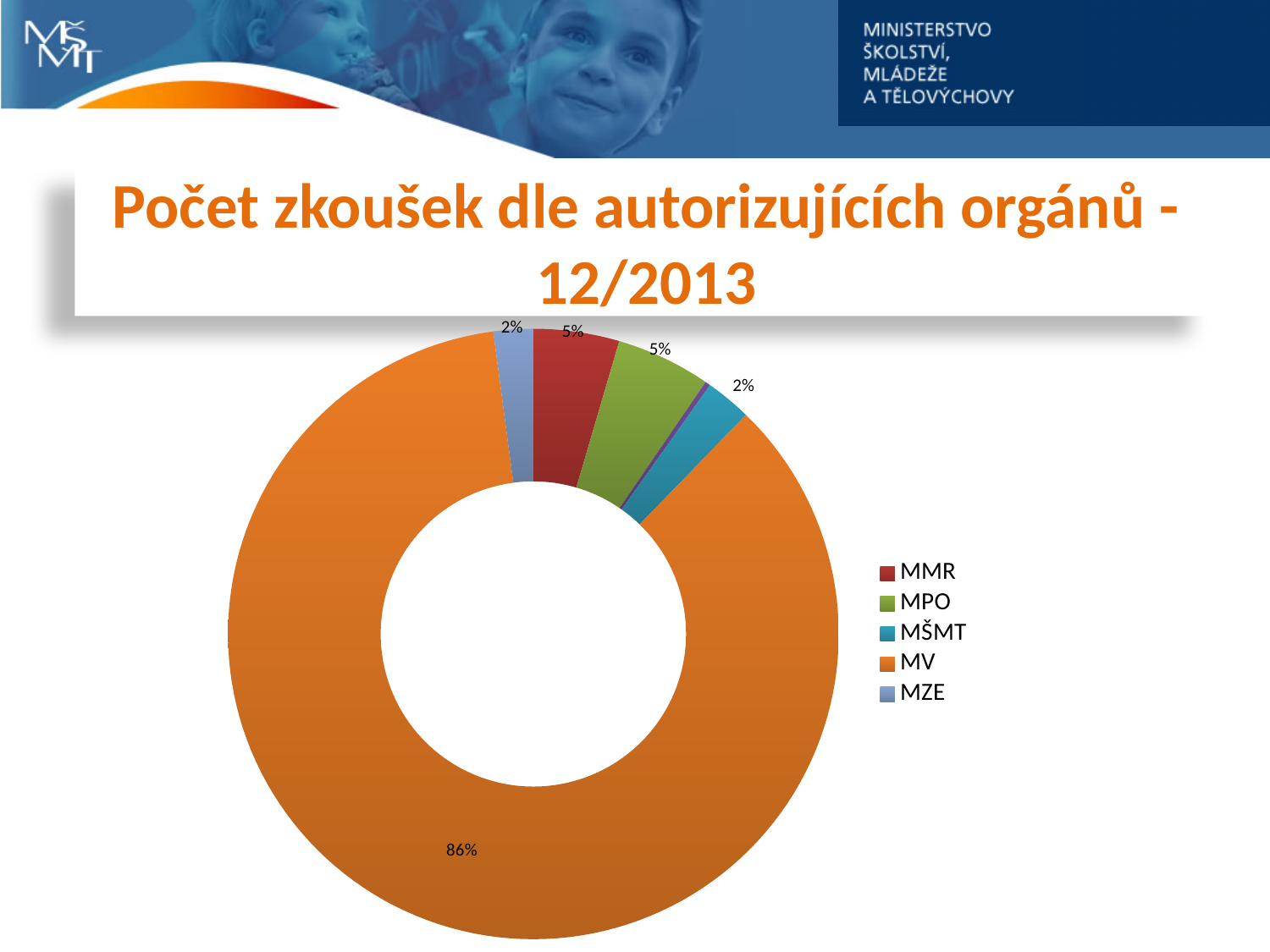
What percentage is shown for MPO? 5% What colour represents MV in the chart? orange What share of the chart does MV account for? 86% What percentage is shown for MZE? 2% What percentage is shown for MMR? 5% What kind of chart is shown on the slide? doughnut chart By how many percentage points does the MV share exceed the MMR share? 81 percentage points What percentage is shown for MŠMT? 2% How many entries does the legend list? 5 What is the title of the chart? Počet zkoušek dle autorizujících orgánů - 12/2013 Which has a larger share, MV or MMR? MV Which authorizing body has the largest share of exams? MV